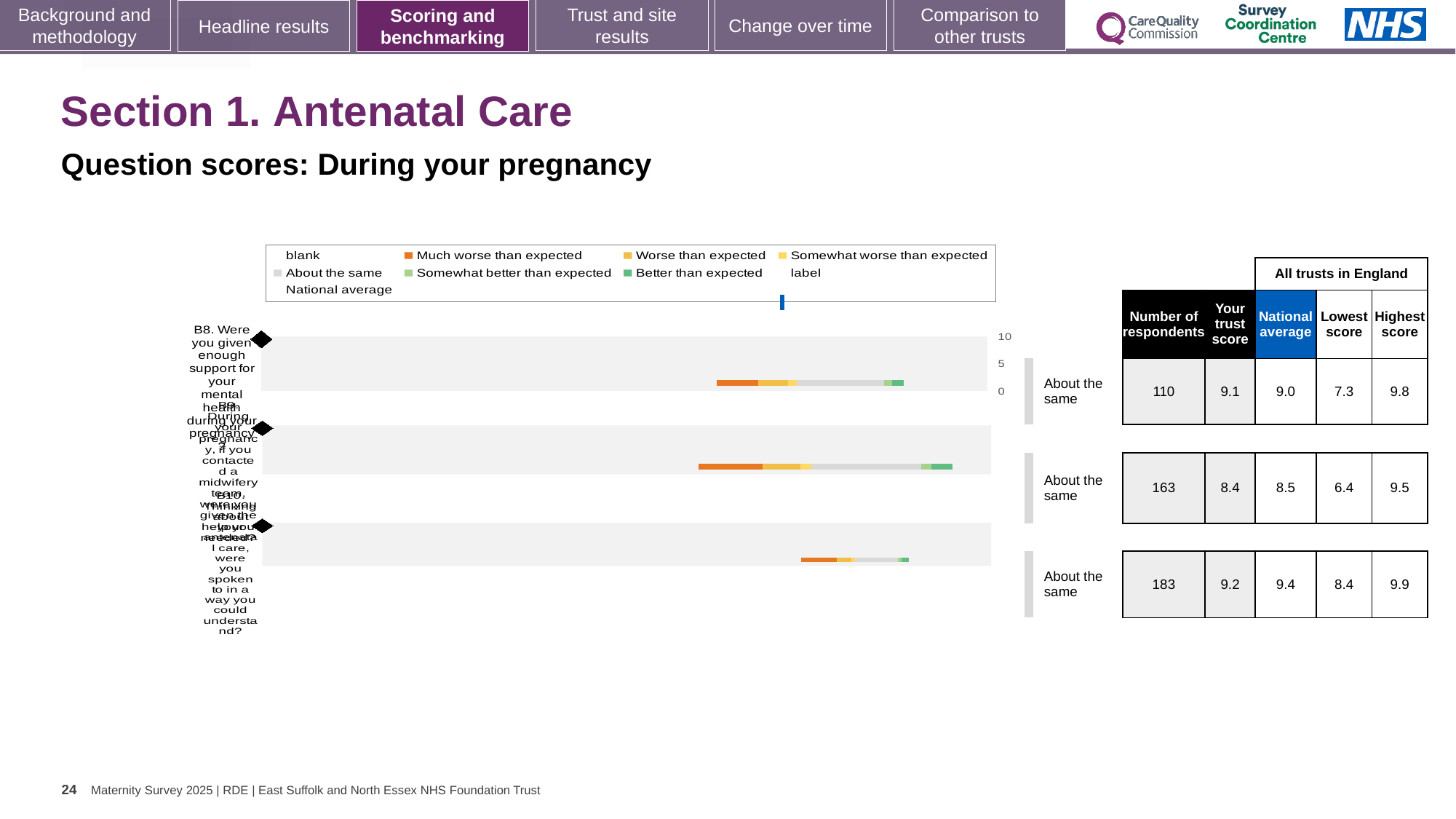
What is the difference between the highest score and the lowest score for question B8? 2.5 How many respondents answered question B8, the top row of the chart? 110 Which row of the chart has the most respondents? the third (bottom) row, with 183 What is the highest score among all trusts in England for the second (middle) row of the chart? 9.5 What is the national average for question B8 (support for your mental health during your pregnancy)? 9.0 What kind of chart is used to show the question scores on this slide? bar chart What is the trust score for question B8 (support for your mental health during your pregnancy)? 9.1 How many questions (rows) are plotted in the chart? 3 What is the lowest score among all trusts in England for the third (bottom) row of the chart? 8.4 For question B8, which is larger: the trust score or the national average? the trust score (9.1) Which row of the chart has the lowest trust score? the second (middle) row, with 8.4 What benchmark category is shown for all three questions in the chart? About the same